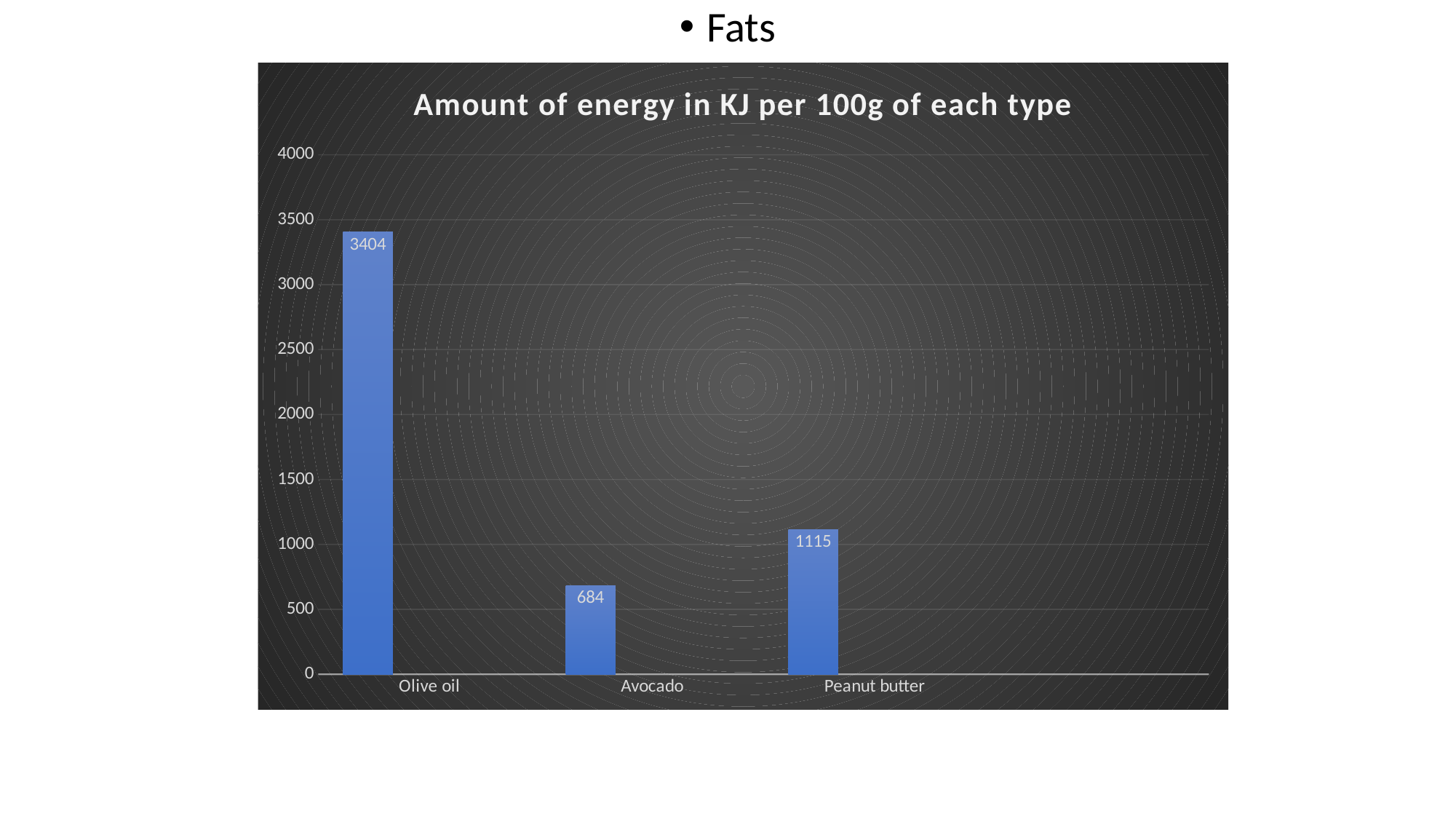
What is the title of the chart? Amount of energy in KJ per 100g of each type Is the value for Olive oil greater or less than 3000? greater Which has a larger energy value, Avocado or Peanut butter? Peanut butter Which type has the lowest energy per 100g? Avocado What is the difference in energy between Olive oil and Peanut butter? 2289 What kind of chart is shown on the slide? bar chart What is the energy value for Olive oil? 3404 What is the difference in energy between Peanut butter and Avocado? 431 What is the energy value for Avocado? 684 What is the energy value for Peanut butter? 1115 Which type has the highest energy per 100g? Olive oil How many categories are shown on the chart? 3